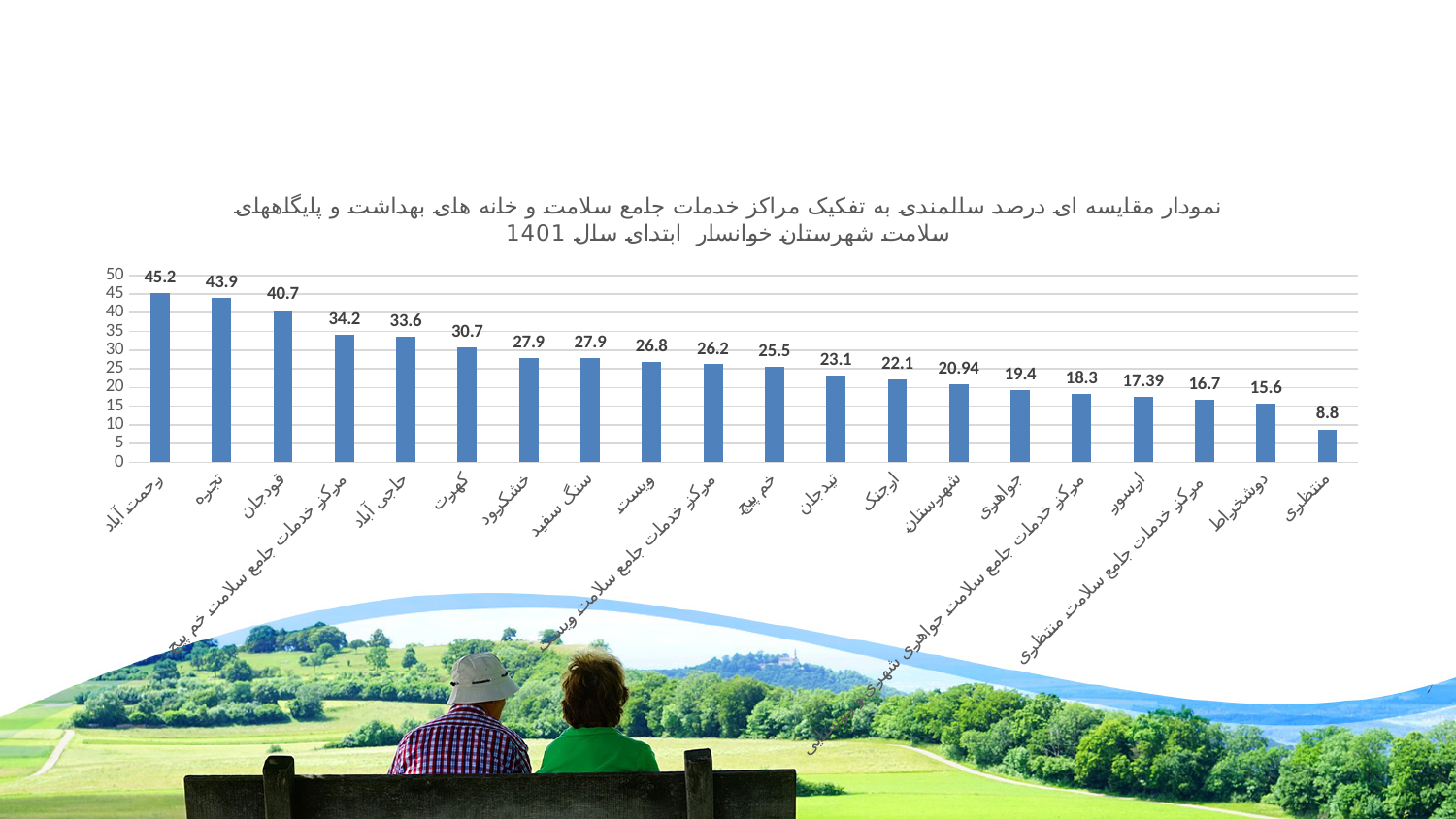
Which is larger, the value for تجره or the value for حاجی آباد? تجره What is the value for رحمت آباد? 45.2 What is the value for ارسور? 17.39 What is the difference between the values for رحمت آباد and منتظری? 36.4 What is the value for قودجان? 40.7 Which category has the highest value in the chart? رحمت آباد Do the values generally rise or fall from left to right across the chart? fall Which year is mentioned in the chart title? 1401 Which category has the lowest value in the chart? منتظری What type of chart is shown on the slide? bar chart How many bars (categories) are plotted in the chart? 20 What is the value for شهرستان? 20.94